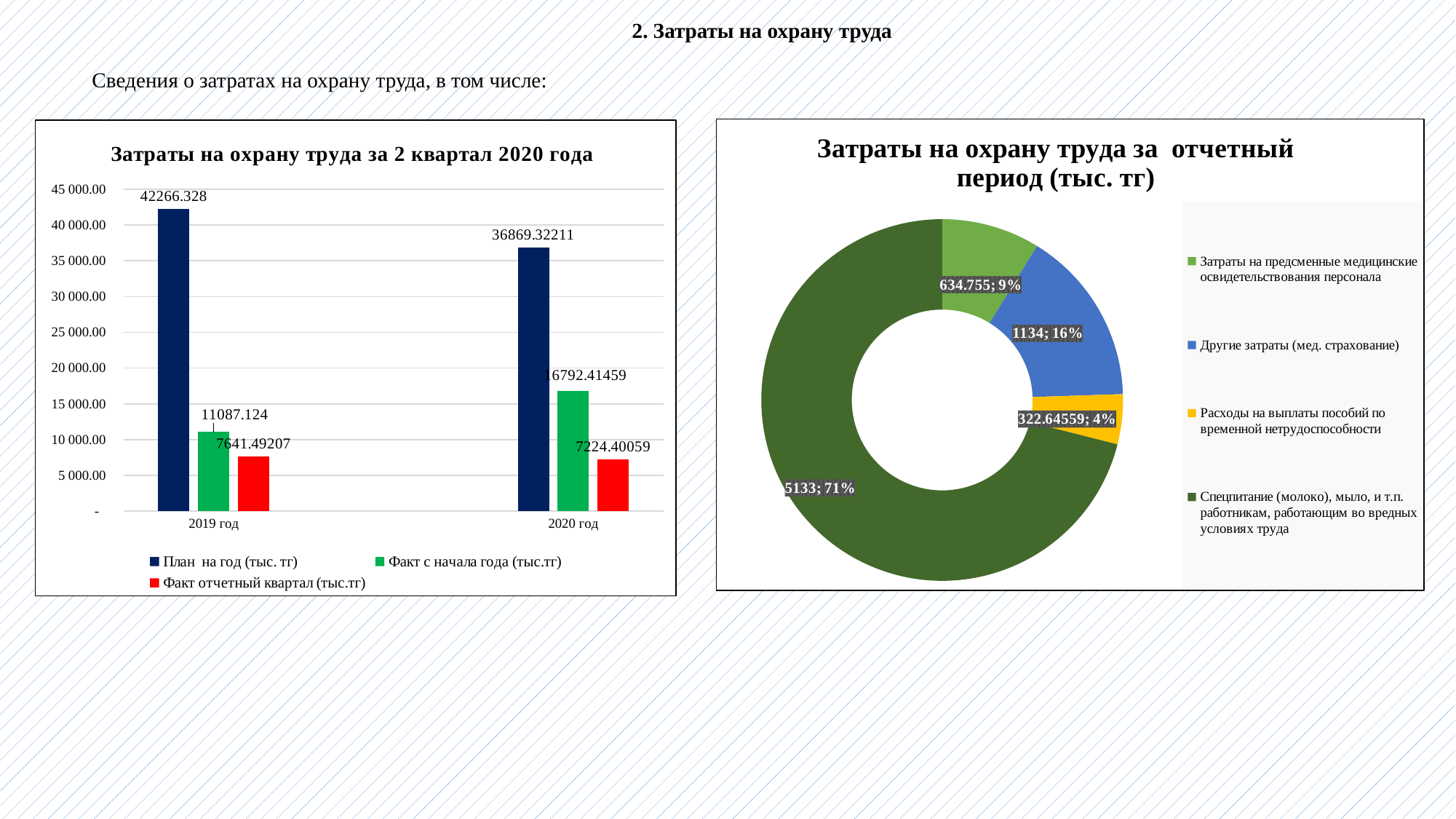
In the chart 'Затраты на охрану труда за отчетный период (тыс. тг)', what is the value for 'Расходы на выплаты пособий по временной нетрудоспособности'? 322.64559 What type of chart is 'Затраты на охрану труда за 2 квартал 2020 года'? Bar chart In the chart 'Затраты на охрану труда за отчетный период (тыс. тг)', what colour is the slice for 'Другие затраты (мед. страхование)'? Blue In the chart 'Затраты на охрану труда за 2 квартал 2020 года', what is the value of 'Факт с начала года (тыс.тг)' for 2020 год? 16792.41459 In the chart 'Затраты на охрану труда за отчетный период (тыс. тг)', which category has the largest share? Спецпитание (молоко), мыло, и т.п. работникам, работающим во вредных условиях труда In the chart 'Затраты на охрану труда за 2 квартал 2020 года', how many series does the legend list? 3 In the chart 'Затраты на охрану труда за отчетный период (тыс. тг)', how many categories are shown? 4 In the chart 'Затраты на охрану труда за 2 квартал 2020 года', what is the difference between 'Факт с начала года (тыс.тг)' for 2020 год and for 2019 год? 5705.29059 In the chart 'Затраты на охрану труда за 2 квартал 2020 года', what is the value of 'План на год (тыс. тг)' for 2019 год? 42266.328 In the chart 'Затраты на охрану труда за 2 квартал 2020 года', what is the value of 'Факт отчетный квартал (тыс.тг)' for 2019 год? 7641.49207 In the chart 'Затраты на охрану труда за 2 квартал 2020 года', which year has the higher 'План на год (тыс. тг)' value? 2019 год In the chart 'Затраты на охрану труда за отчетный период (тыс. тг)', what share does 'Другие затраты (мед. страхование)' have? 16%